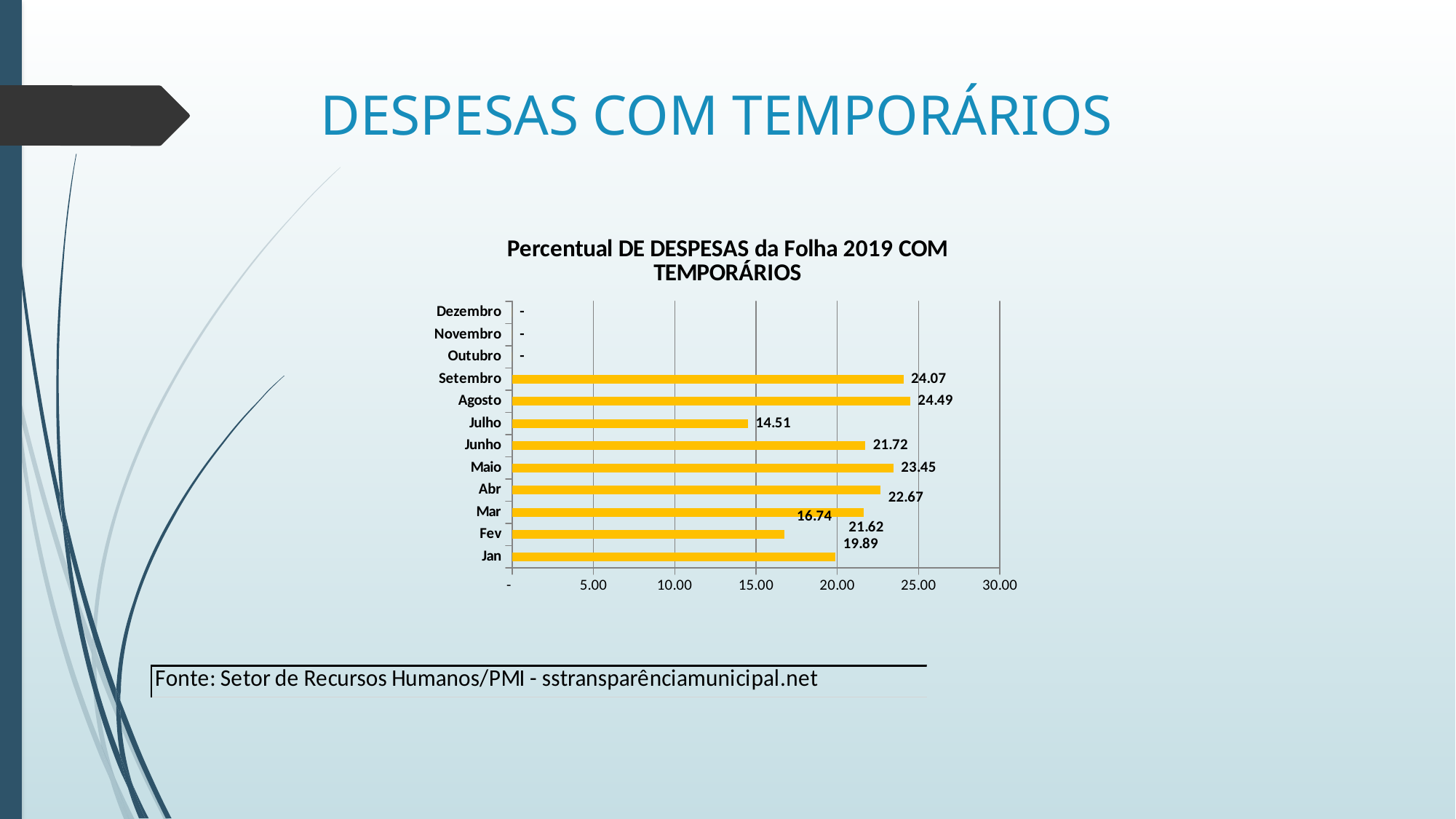
What kind of chart is shown on the slide? bar chart What is the value for Junho? 21.72 What is the difference between the values for Agosto and Setembro? 0.42 Among the months with a plotted bar, which has the lowest value? Julho What is the value for Maio? 23.45 Which month has the highest value? Agosto What is the value for Julho? 14.51 What is the value for Setembro? 24.07 What is the difference between the values for Maio and Junho? 1.73 Is the value for Fev greater or less than 20.00? less Which is larger, the value for Abr or the value for Julho? Abr How many months are listed on the vertical axis? 12